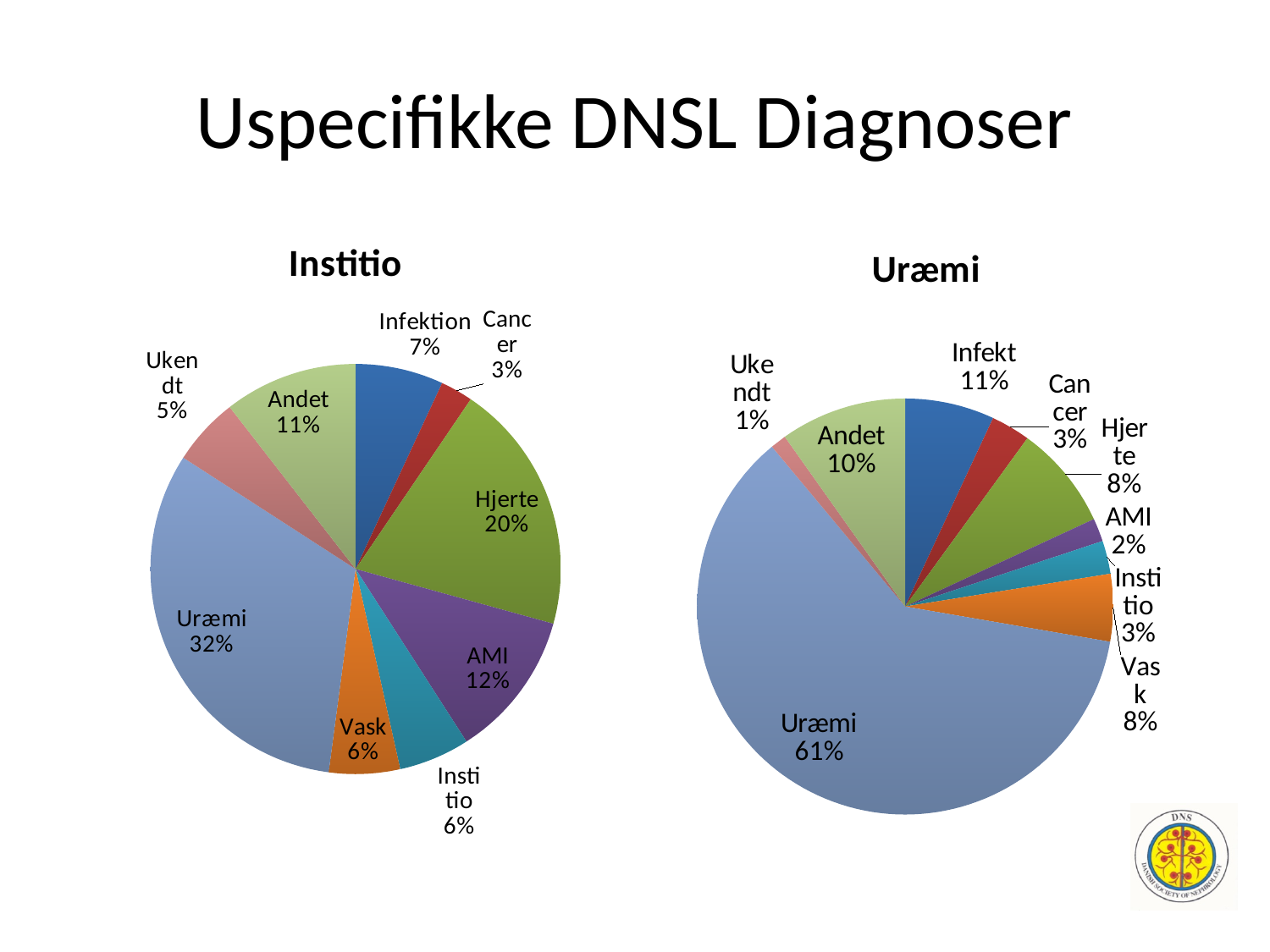
How many slices does the Uræmi pie chart have? 9 What is the title of the chart on the right side of the slide? Uræmi In the Uræmi pie chart, which category has the smallest slice? Ukendt In the Institio pie chart, what is the difference between the Uræmi share and the Hjerte share? 12% In the Uræmi pie chart, what share does Andet have? 10% In the Institio pie chart, which is larger, AMI or Infektion? AMI In the Institio pie chart, what share does Hjerte have? 20% In the Institio pie chart, which category has the largest slice? Uræmi In the Institio pie chart, what share does Uræmi have? 32% In the Uræmi pie chart, what is the difference between the Infekt share and the Cancer share? 8% What type of chart is the Institio chart? Pie chart